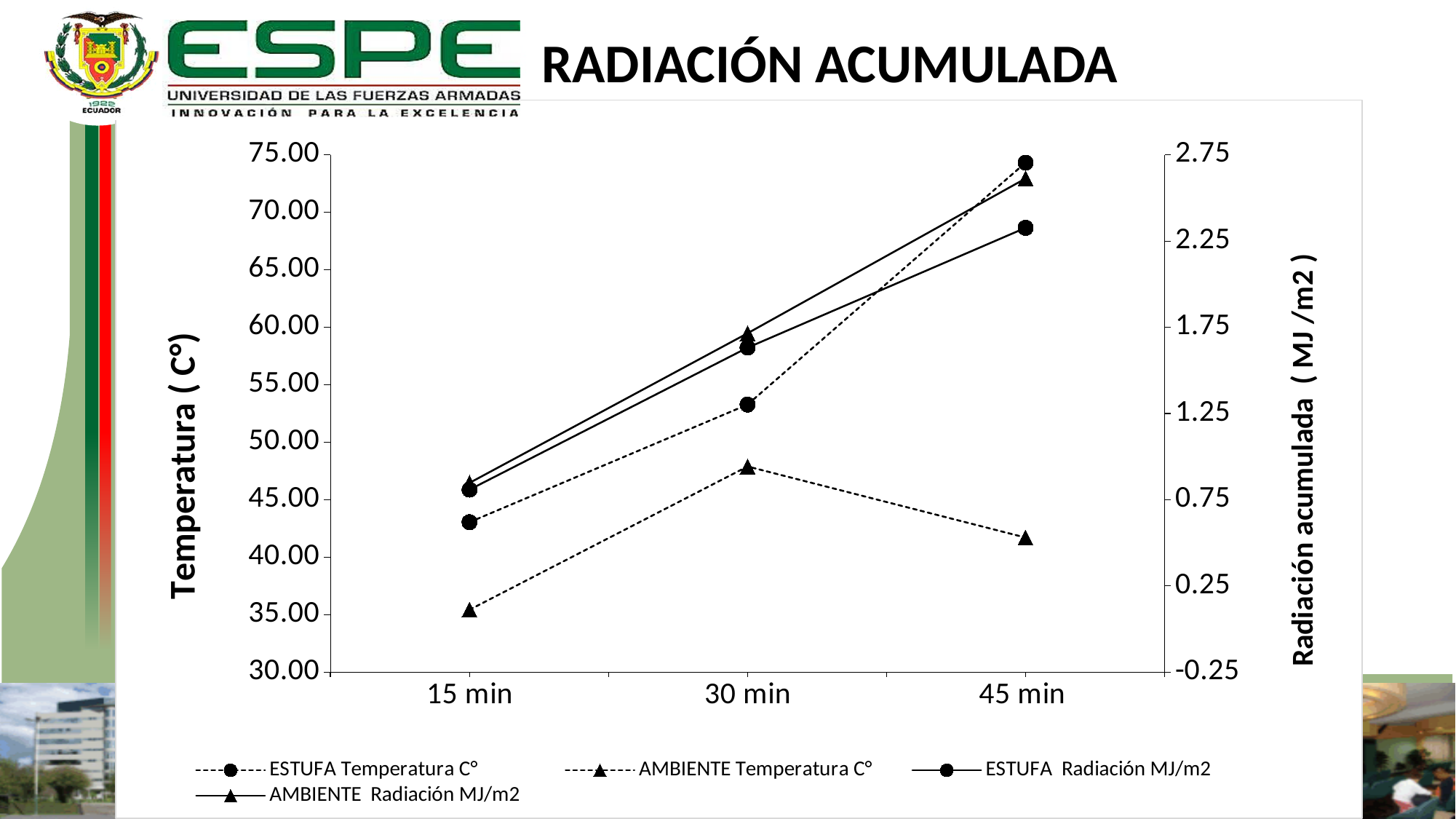
At which time point is the AMBIENTE Temperatura C° series lowest? 15 min Does the AMBIENTE Temperatura C° series rise or fall between 30 min and 45 min? fall Is the AMBIENTE Temperatura C° value at 15 min greater or less than 40.00? less At 30 min, which is larger: ESTUFA Temperatura C° or AMBIENTE Temperatura C°? ESTUFA Temperatura C° At which time point is the ESTUFA Temperatura C° series highest? 45 min Is the ESTUFA Temperatura C° value at 45 min greater or less than 70.00? greater How many time points are plotted along the x axis? 3 Is the AMBIENTE Radiación MJ/m2 value at 45 min greater or less than 2.25? greater What is the title of the chart? RADIACIÓN ACUMULADA What kind of chart is shown on the slide? line chart Does the ESTUFA Temperatura C° series rise or fall from 15 min to 45 min? rise How many series does the legend list? 4